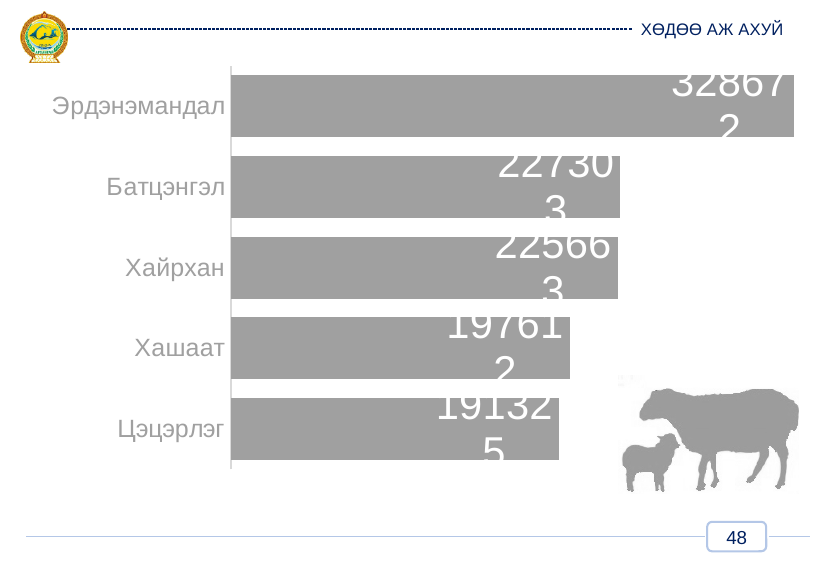
What is the value for Хайрхан? 225663 Which is larger, the value for Батцэнгэл or the value for Хашаат? Батцэнгэл What is the difference between the values for Хашаат and Цэцэрлэг? 6287 What kind of chart is shown on the slide? bar chart What is the value for Батцэнгэл? 227303 What is the value for Эрдэнэмандал? 328672 Which category has the highest value? Эрдэнэмандал What is the value for Хашаат? 197612 How many categories are shown in the chart? 5 Which category has the lowest value? Цэцэрлэг What is the value for Цэцэрлэг? 191325 What is the difference between the values for Эрдэнэмандал and Батцэнгэл? 101369